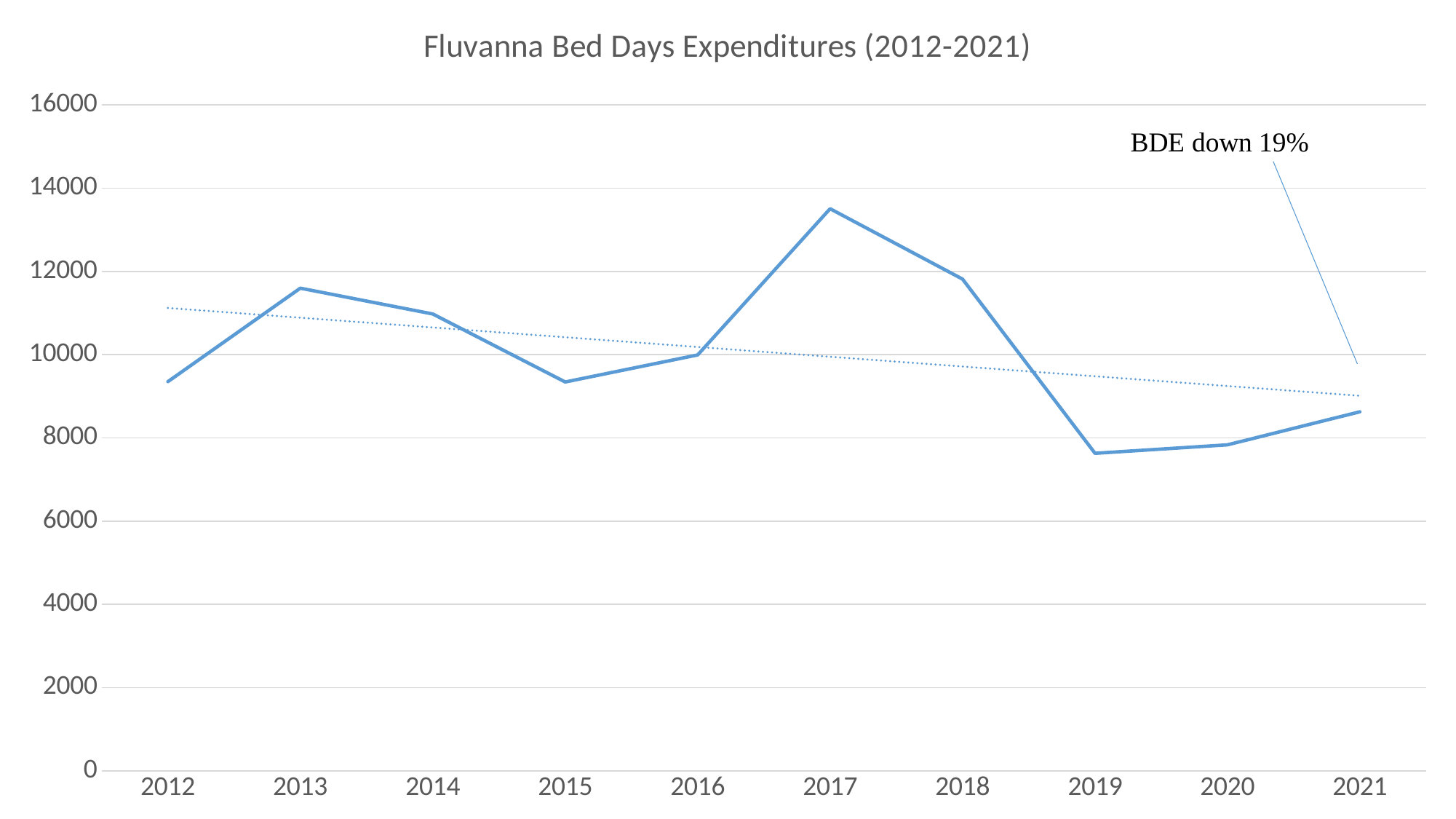
What is the title of the chart? Fluvanna Bed Days Expenditures (2012-2021) How many years are plotted on the x axis? 10 Which is larger, the value for 2017 or the value for 2018? 2017 Is the value for 2019 greater or less than 8000? less What kind of chart is shown on the slide? line chart What does the annotation near the 2021 point say? BDE down 19% Is the value for 2017 greater or less than 12000? greater Is the value for 2018 greater or less than 10000? greater Which is larger, the value for 2013 or the value for 2015? 2013 According to the dotted trendline, do the values generally rise or fall from 2012 to 2021? fall Which year has the highest bed days expenditure? 2017